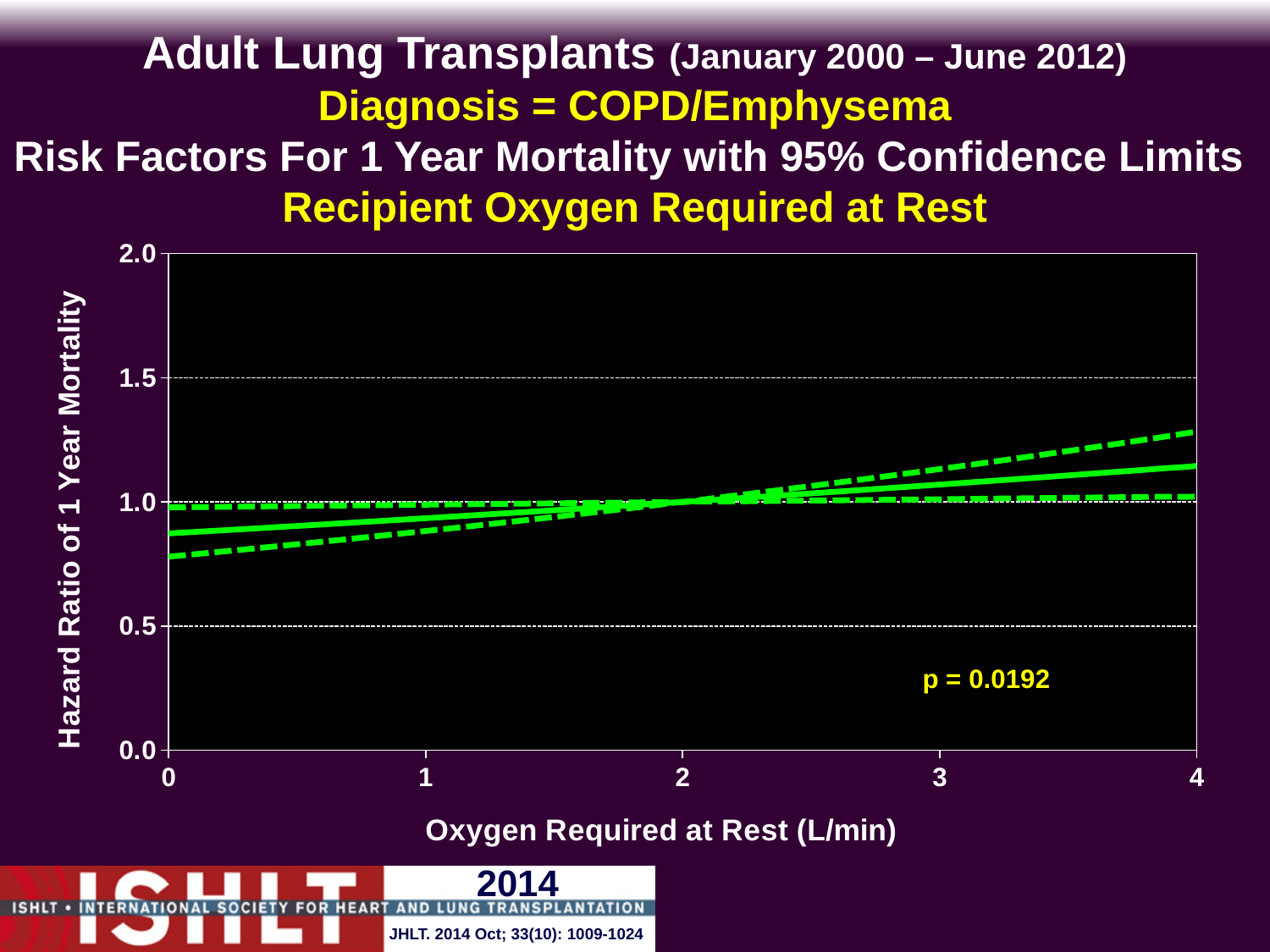
Is the lower dashed confidence limit at 0 L/min greater or less than 0.5? greater Is the hazard ratio of the solid line at 4 L/min greater or less than 1.0? greater Is the solid line's hazard ratio at 4 L/min higher or lower than at 0 L/min? higher Is the upper dashed confidence limit at 4 L/min greater or less than 1.5? less What is the label of the y-axis? Hazard Ratio of 1 Year Mortality How many lines are plotted on the chart? 3 What kind of chart is shown on the slide? line chart What is the p-value printed on the chart? p = 0.0192 Does the solid hazard ratio line rise or fall as oxygen required at rest increases from 0 to 4 L/min? rise What is the highest value shown on the y-axis? 2.0 What is the highest value shown on the x-axis? 4